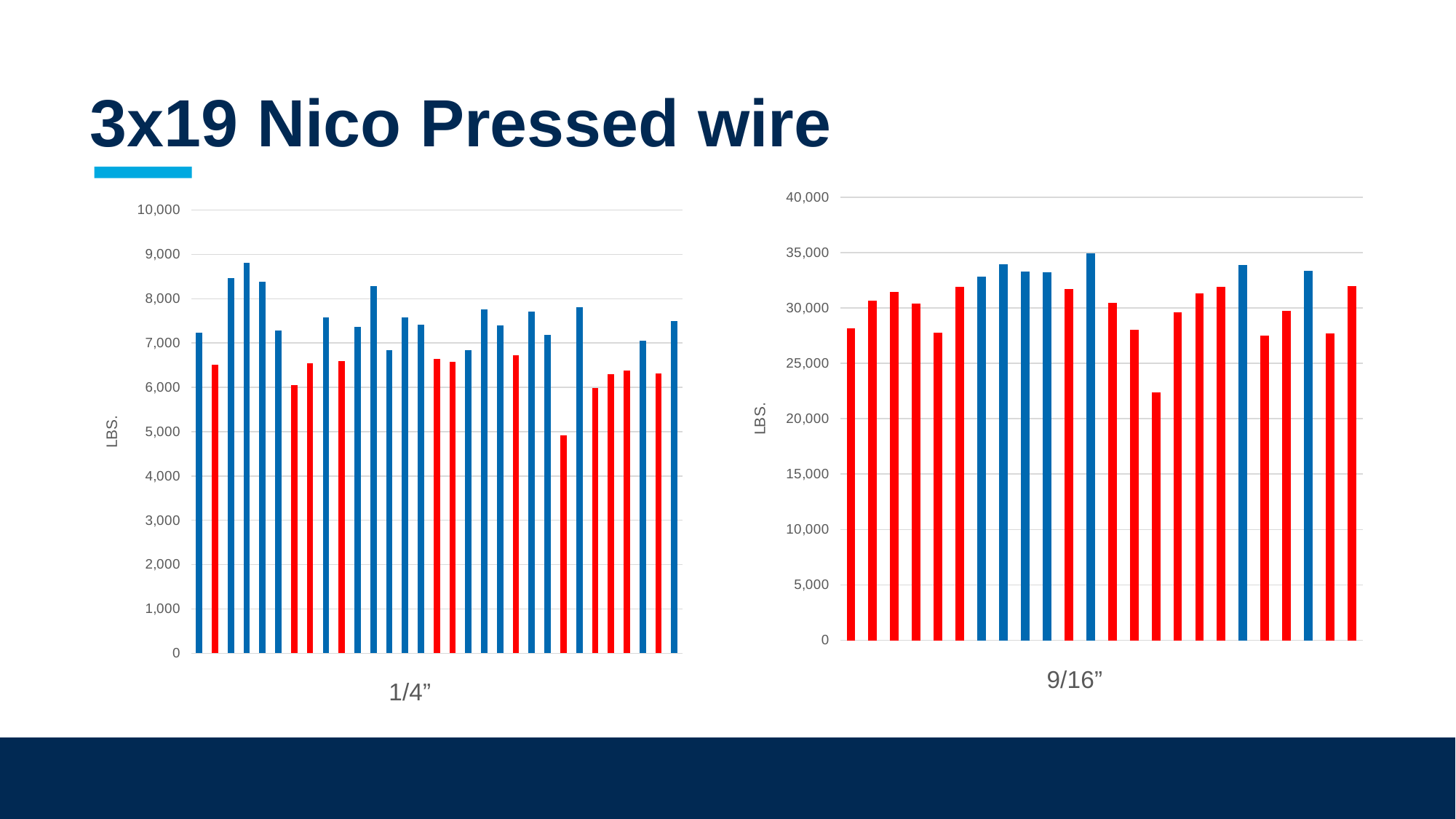
What is the label on the vertical axis of the 9/16" chart? LBS. In the 9/16" chart, is the first bar on the left greater or less than 25,000? greater In the 1/4" chart, which colour of bar is the tallest, blue or red? Blue What kind of chart is the 1/4" chart on the left of the slide? Bar chart In the 1/4" chart, is the tallest bar greater or less than 8,000? greater In the 1/4" chart, is the shortest bar greater or less than 6,000? less In the 1/4" chart, is the tallest blue bar taller or shorter than the tallest red bar? Taller In the 9/16" chart, which colour of bar is the shortest, blue or red? Red What is the highest value shown on the vertical axis of the 1/4" chart? 10,000 What kind of chart is the 9/16" chart on the right of the slide? Bar chart